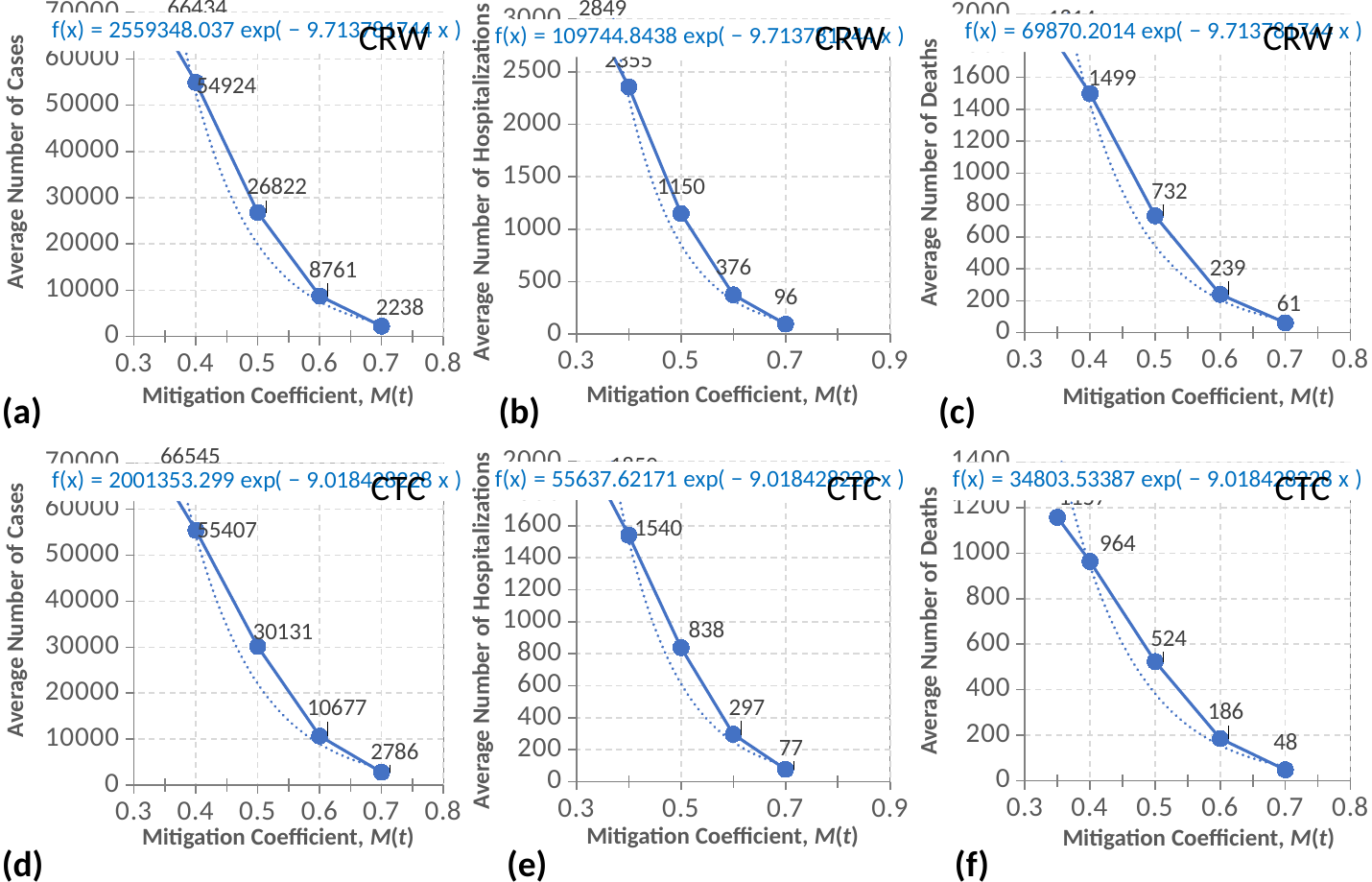
In chart (f), the CTC Average Number of Deaths chart, what is the value at mitigation coefficient 0.5? 524 In chart (c), the CRW Average Number of Deaths chart, what is the difference between the values at mitigation coefficients 0.5 and 0.6? 493 In chart (b), the CRW Average Number of Hospitalizations chart, is the value at mitigation coefficient 0.5 greater or less than 1000? greater In chart (e), the CTC Average Number of Hospitalizations chart, which is larger: the value at 0.5 or the value at 0.6? 0.5 In chart (a), the CRW Average Number of Cases chart, what is the value at mitigation coefficient 0.5? 26822 In chart (a), the CRW Average Number of Cases chart, what is the value at mitigation coefficient 0.7? 2238 In chart (e), the CTC Average Number of Hospitalizations chart, what is the value at mitigation coefficient 0.7? 77 In chart (b), the CRW Average Number of Hospitalizations chart, what is the value at mitigation coefficient 0.6? 376 In chart (c), the CRW Average Number of Deaths chart, what is the value at mitigation coefficient 0.4? 1499 What is the x-axis label shared by all six charts on the slide? Mitigation Coefficient, M(t) In chart (d), the CTC Average Number of Cases chart, do the values rise or fall as the mitigation coefficient increases? fall In chart (d), the CTC Average Number of Cases chart, what is the value at mitigation coefficient 0.6? 10677